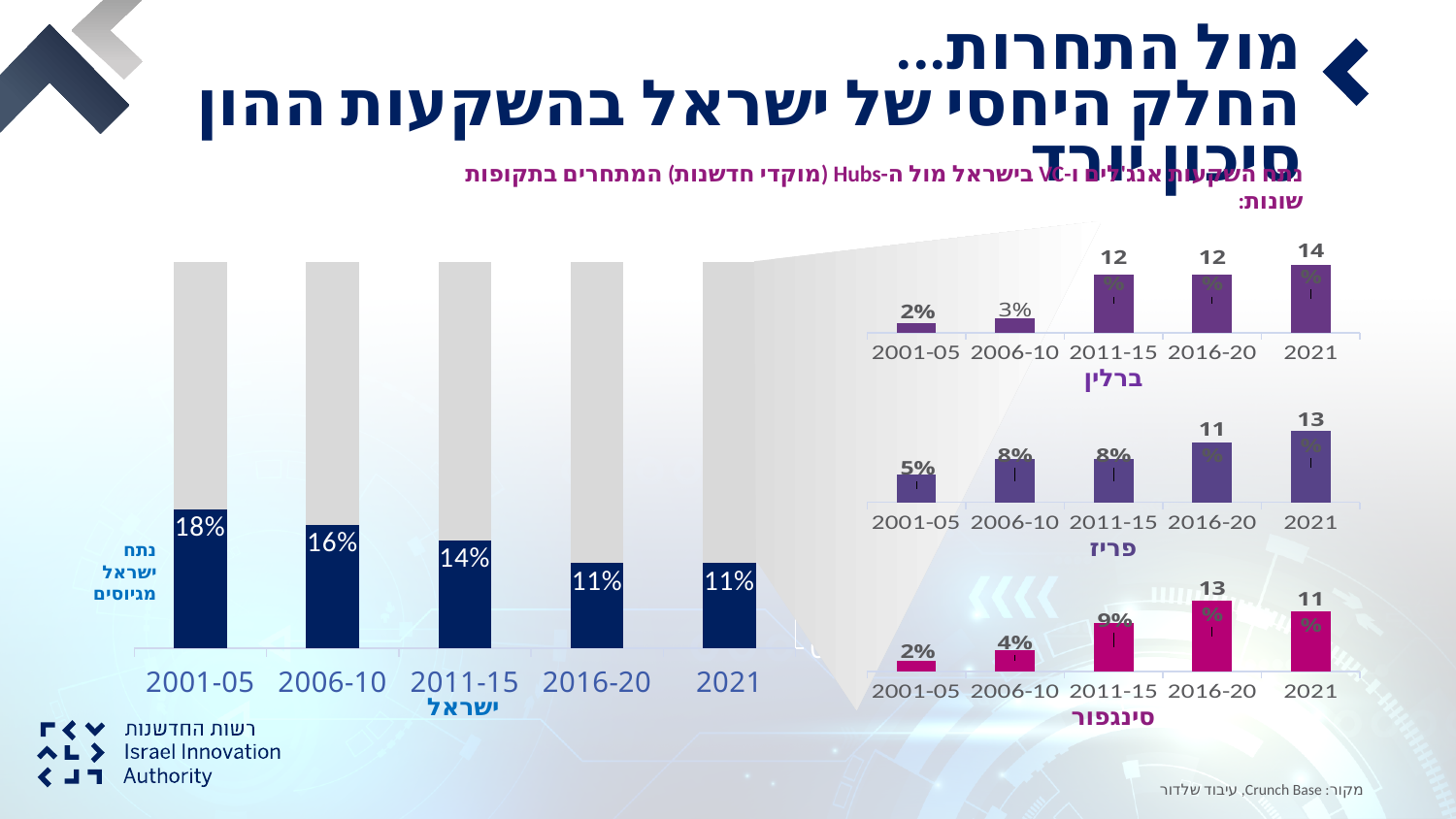
In the top-right chart labelled ברלין, which period has the lowest value? 2001-05 In the large chart on the left labelled ישראל, what is the difference between the 2001-05 value and the 2011-15 value? 4% In the large chart on the left labelled ישראל, what is the value for 2001-05? 18% What kind of chart is the large chart on the left labelled ישראל? bar chart In the large chart on the left labelled ישראל, do the values rise or fall from 2001-05 to 2021? fall In the bottom-right chart labelled סינגפור, which is larger, the value for 2016-20 or the value for 2021? 2016-20 In the top-right chart labelled ברלין, what is the value for 2021? 14% In the bottom-right chart labelled סינגפור, what is the difference between the 2011-15 value and the 2006-10 value? 5% In the middle-right chart labelled פריז, which period has the highest value? 2021 In the large chart on the left labelled ישראל, how many time periods are shown on the x axis? 5 In the large chart on the left labelled ישראל, what is the value for 2016-20? 11% In the middle-right chart labelled פריז, what is the value for 2001-05? 5%